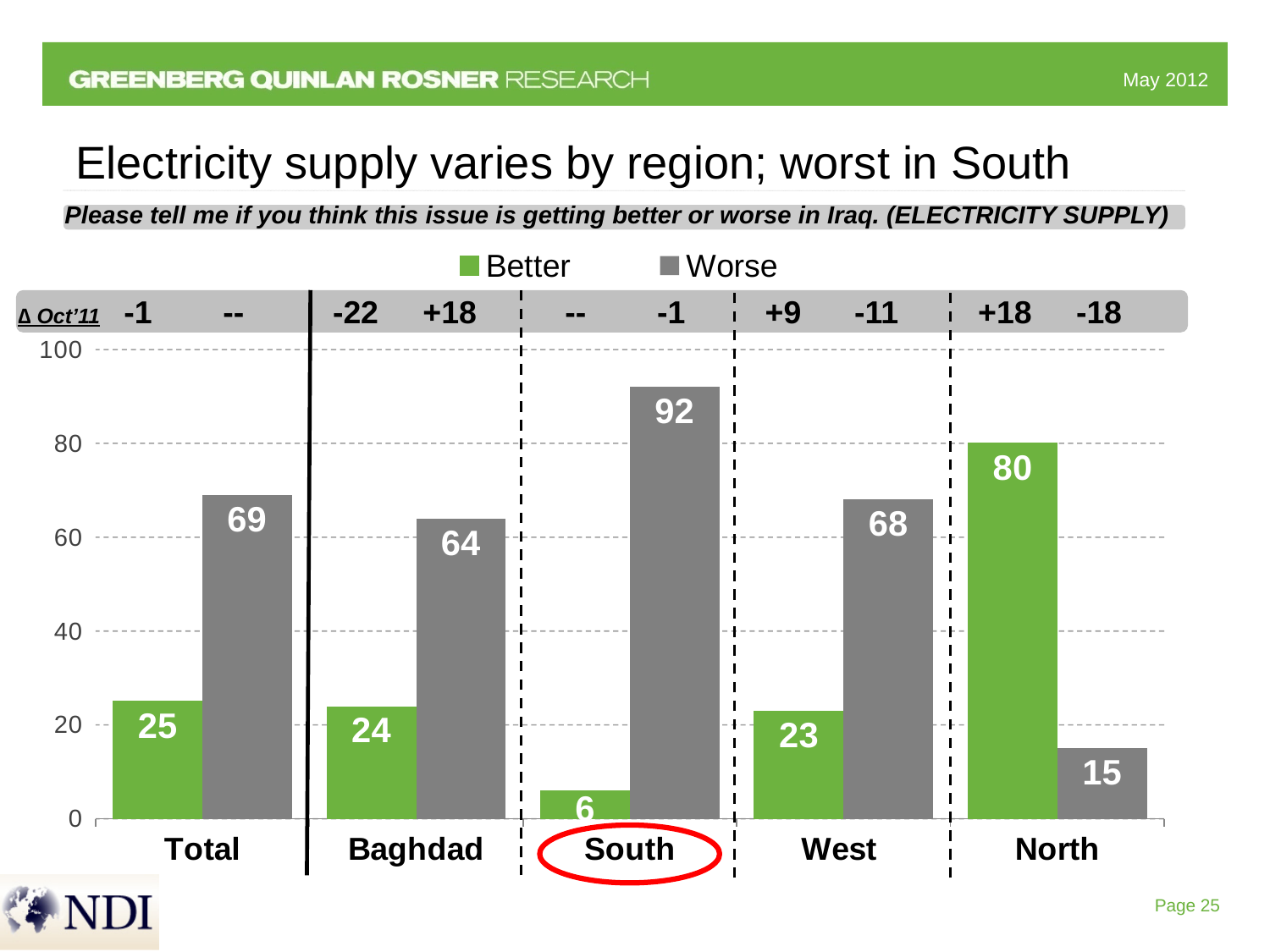
What is the value for Better in Baghdad? 24 Which region has the lowest Better value? South Which is larger in the West: Better or Worse? Worse How many categories are shown on the x axis? 5 What kind of chart is shown on the slide? bar chart Is the Worse value for the North greater or less than 20? less What is the difference between Worse and Better for the Total? 44 What is the value for Worse in the South? 92 What colour represents the Better series? green What is the value for Better in the North? 80 Which region has the highest Worse value? South How many series does the legend list? 2